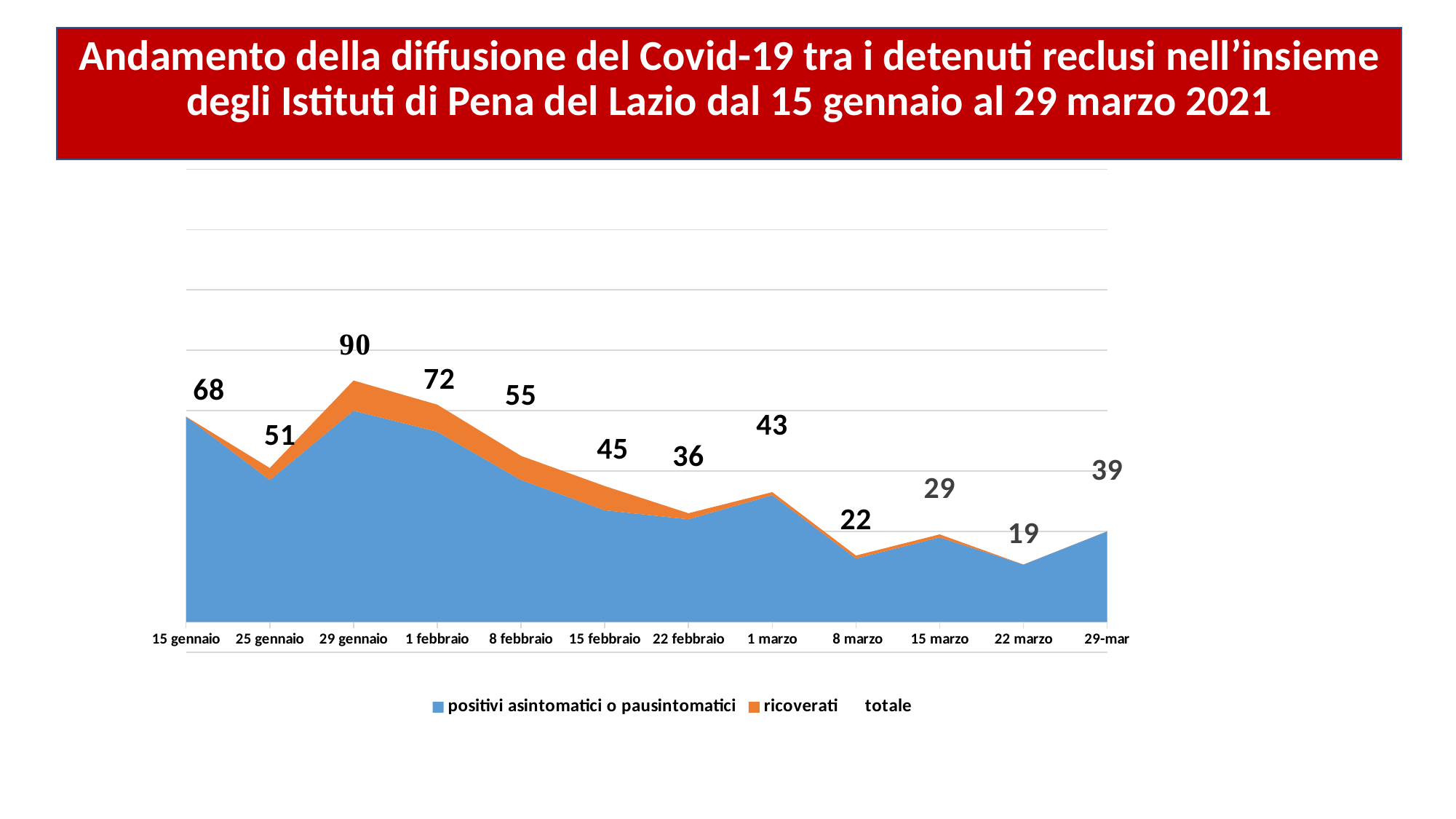
What is the difference between the totale values for 29 gennaio and 1 febbraio? 18 How many series does the legend list? 3 Which date has the lowest totale value? 22 marzo What kind of chart is shown on the slide? area chart How many dates are shown on the x axis? 12 What is the totale value for 29 gennaio? 90 What is the totale value for 29-mar? 39 What is the difference between the totale values for 15 gennaio and 29-mar? 29 Which is larger, the totale value for 1 marzo or for 22 febbraio? 1 marzo Which date has the highest totale value? 29 gennaio What is the totale value for 15 febbraio? 45 Which colour represents the 'ricoverati' series? orange